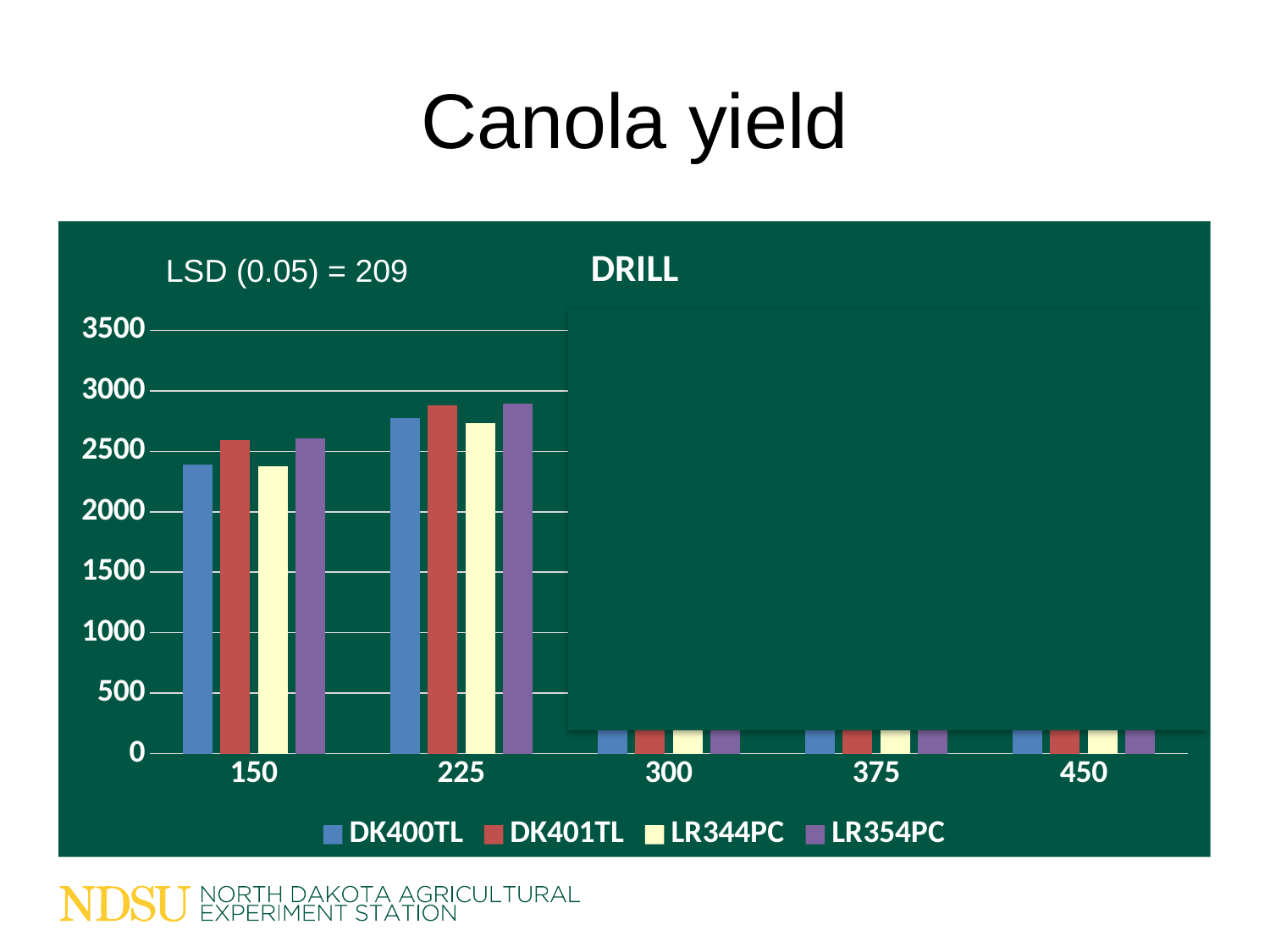
How many categories are shown on the x axis? 5 What kind of chart is shown on the slide? bar chart Do the LR344PC values rise or fall from 150 to 225? rise Is the value for LR344PC at 150 greater or less than 2500? less What LSD (0.05) value is printed on the chart? 209 Is the value for DK400TL at 150 greater or less than 2500? less Is the value for DK400TL at 225 greater or less than 3000? less How many series does the legend list? 4 For DK400TL, which is larger: the value at 150 or the value at 225? 225 At 150, which is larger: DK400TL or DK401TL? DK401TL